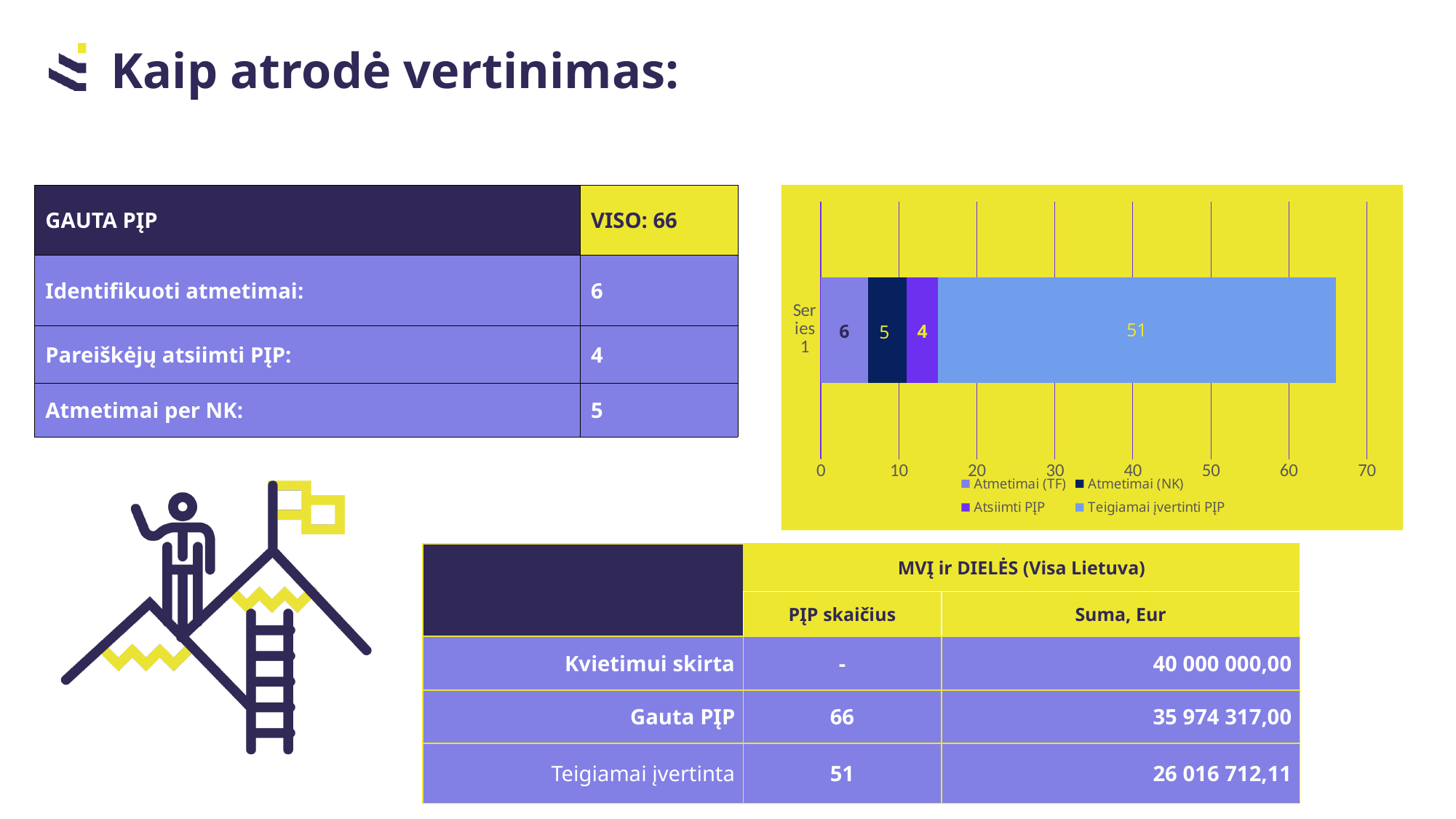
Which series has the largest value in the chart? Teigiamai įvertinti PĮP What kind of chart is shown on the slide? bar chart Which is larger in the chart, Atmetimai (TF) or Atmetimai (NK)? Atmetimai (TF) What is the total of the stacked bar in the chart? 66 What is the difference between the Teigiamai įvertinti PĮP value and the Atmetimai (TF) value in the chart? 45 How many categories are plotted on the chart's vertical axis? 1 How many series does the chart legend list? 4 What is the value of the Atmetimai (TF) segment in the chart? 6 Which series has the smallest value in the chart? Atsiimti PĮP What is the value of the Teigiamai įvertinti PĮP segment in the chart? 51 What is the value of the Atsiimti PĮP segment in the chart? 4 What is the value of the Atmetimai (NK) segment in the chart? 5